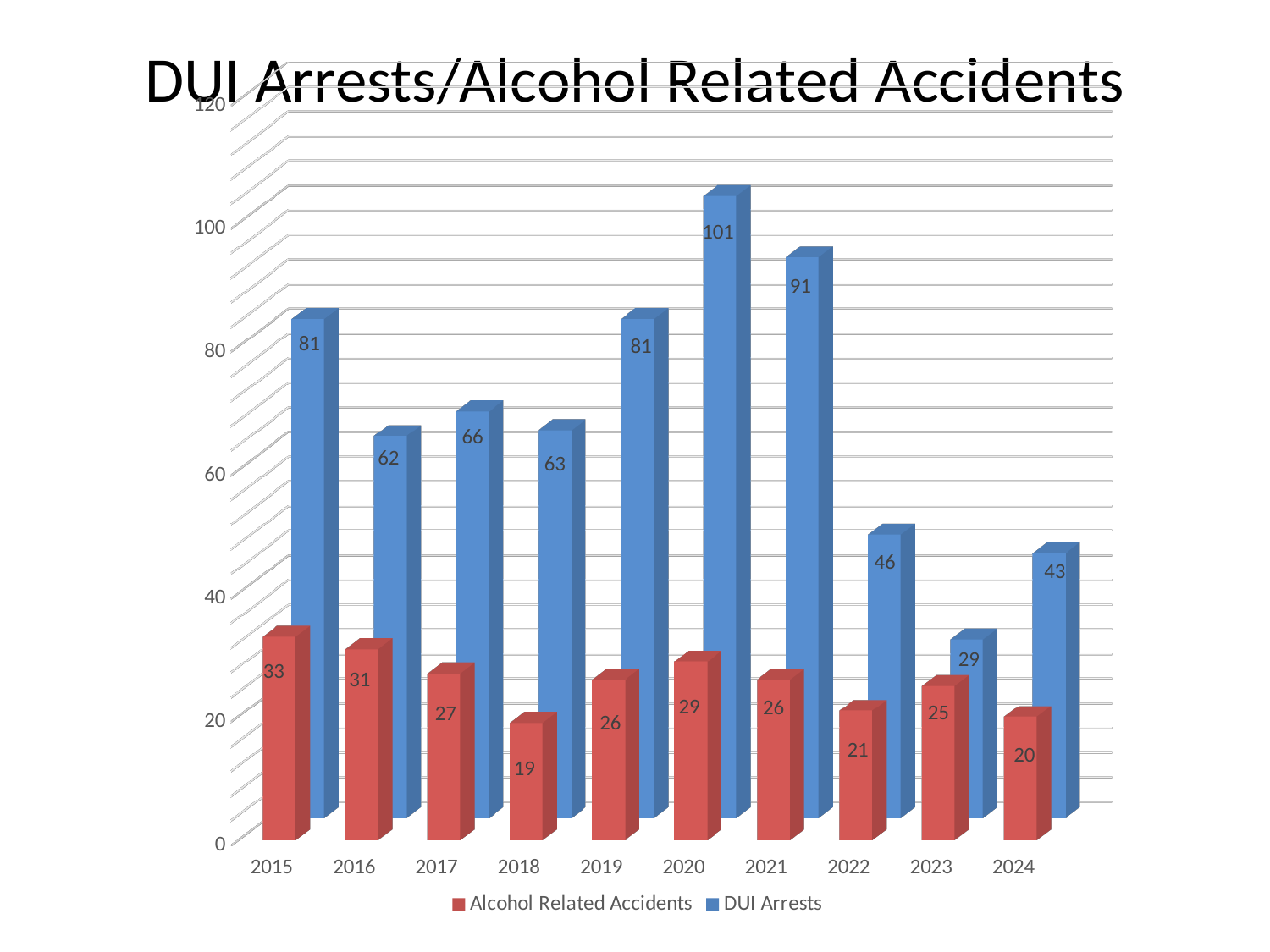
Do the DUI Arrests values rise or fall from 2021 to 2023? fall What is the value for Alcohol Related Accidents in 2018? 19 What is the value for DUI Arrests in 2020? 101 Which is larger, DUI Arrests in 2016 or DUI Arrests in 2017? DUI Arrests in 2017 What is the difference between DUI Arrests in 2021 and 2022? 45 Which year has the lowest number of Alcohol Related Accidents? 2018 Is the value for DUI Arrests in 2019 greater or less than 60? greater Which year has the highest number of DUI Arrests? 2020 How many years are shown on the x axis? 10 What is the title of the chart? DUI Arrests/Alcohol Related Accidents How many series does the legend list? 2 What kind of chart is shown on the slide? bar chart